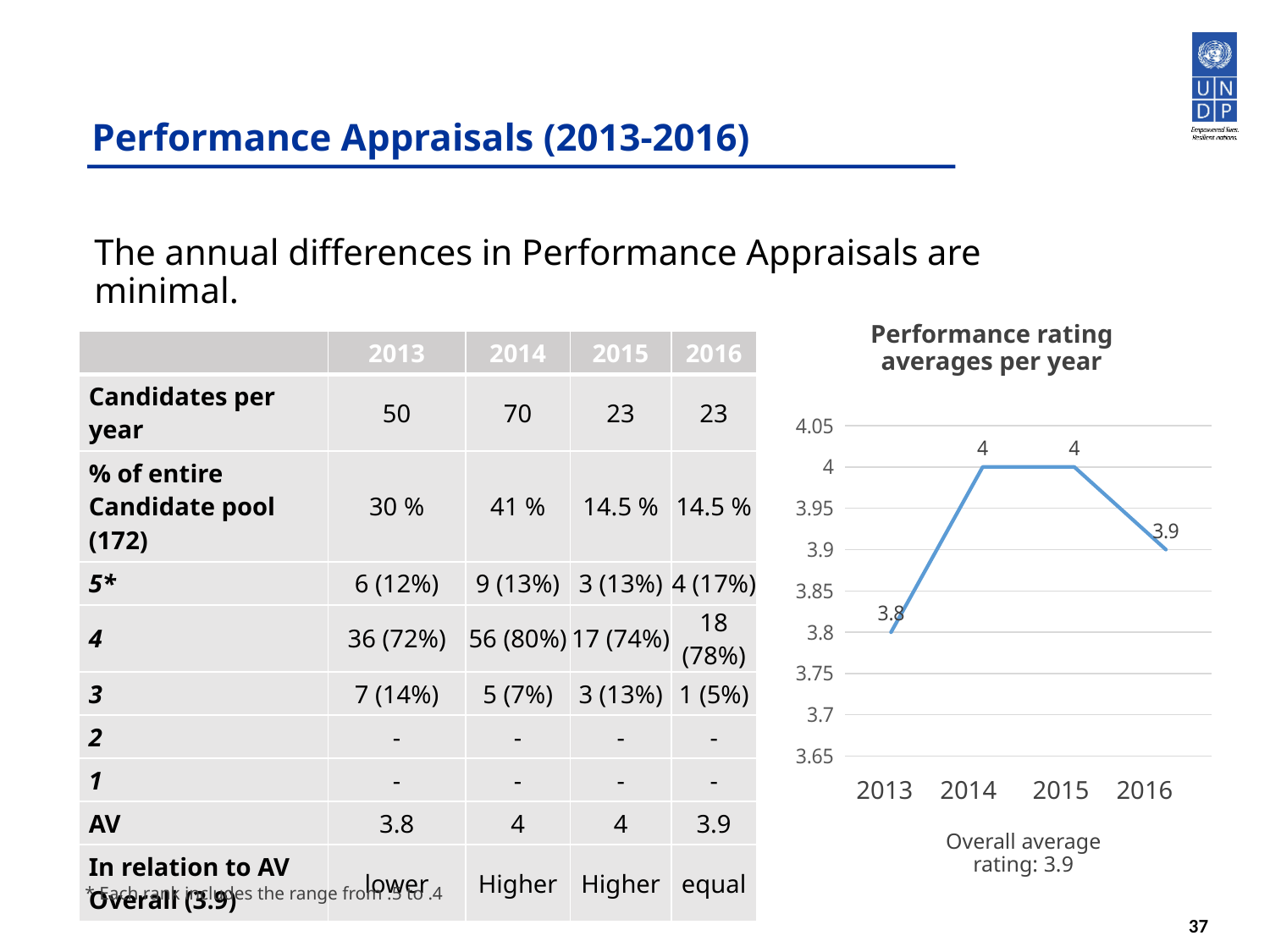
Is the value for 2013 in the chart greater or less than 3.9? less What is the performance rating average for 2014 in the chart? 4 What is the title of the chart? Performance rating averages per year Which is larger in the chart, the value for 2016 or the value for 2013? 2016 What is the performance rating average for 2013 in the chart? 3.8 How many years are plotted on the x axis of the chart? 4 What is the difference between the performance rating averages for 2015 and 2016? 0.1 What type of chart is shown on the slide? line chart Does the performance rating average rise or fall from 2015 to 2016 in the chart? fall What is the performance rating average for 2016 in the chart? 3.9 What is the difference between the performance rating averages for 2014 and 2013? 0.2 Which year has the lowest performance rating average in the chart? 2013